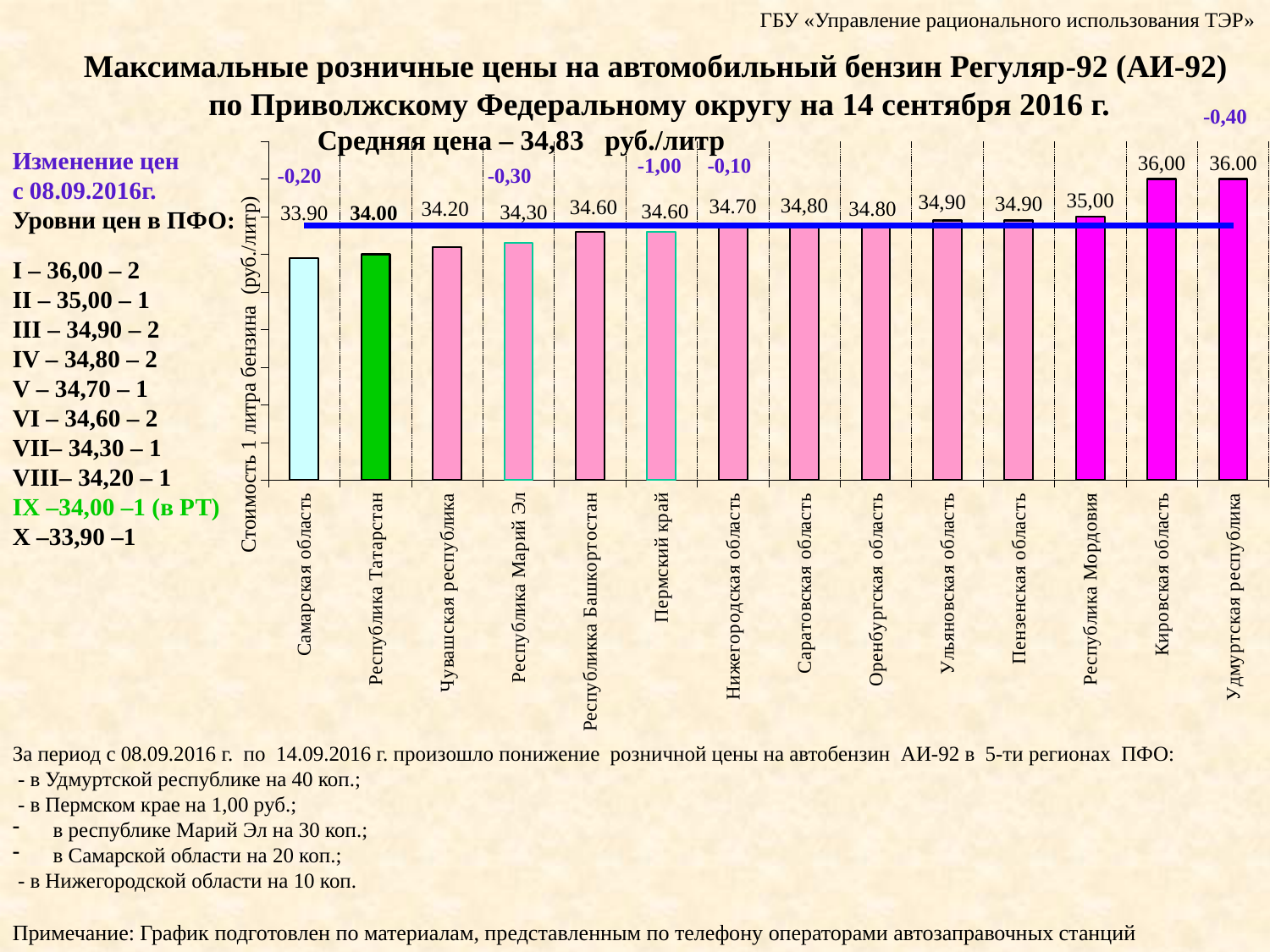
What is the value shown for Нижегородская область? 34.70 Which is larger, the value for Чувашская республика or the value for Пермский край? Пермский край What is the value shown for Республика Мордовия? 35,00 What is the value shown for Республика Татарстан? 34.00 Do the values generally rise or fall from left to right along the x axis? rise Which region has the lowest value on the chart? Самарская область How many regions are plotted on the chart? 14 What average price is stated in the chart title? 34,83 руб./литр What is the value shown for Самарская область? 33.90 What is the difference between the values for Республика Мордовия and Республика Марий Эл? 0,70 What kind of chart is shown on the slide? bar chart What is the difference between the values for Кировская область and Самарская область? 2,10